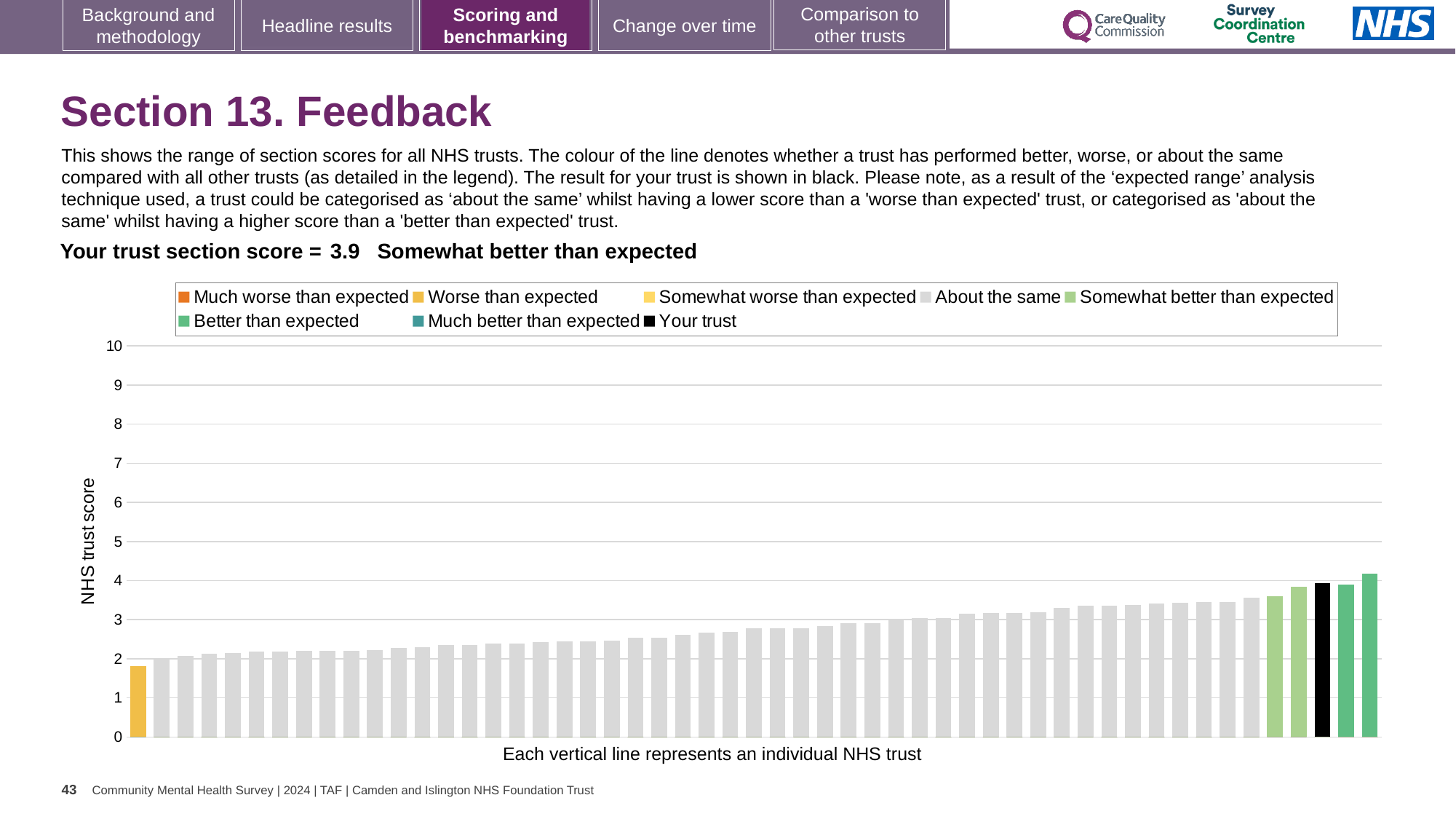
What kind of chart is shown on the slide? bar chart What is the label on the vertical axis of the chart? NHS trust score Do the bar values rise or fall moving from left to right along the x axis? rise Which is larger: the value for your trust (the black bar) or the value of the rightmost bar? the rightmost bar How many bars are coloured as 'Worse than expected'? 1 Is the value of the leftmost bar greater or less than 3? less Is the value for your trust (the black bar) greater or less than 5? less Is the value for your trust (the black bar) greater or less than 3? greater What is the section score for your trust shown on the slide? 3.9 How many entries does the chart legend list? 8 Which is larger: the value for your trust (the black bar) or the value of the leftmost bar? your trust What colour is the bar representing your trust? black